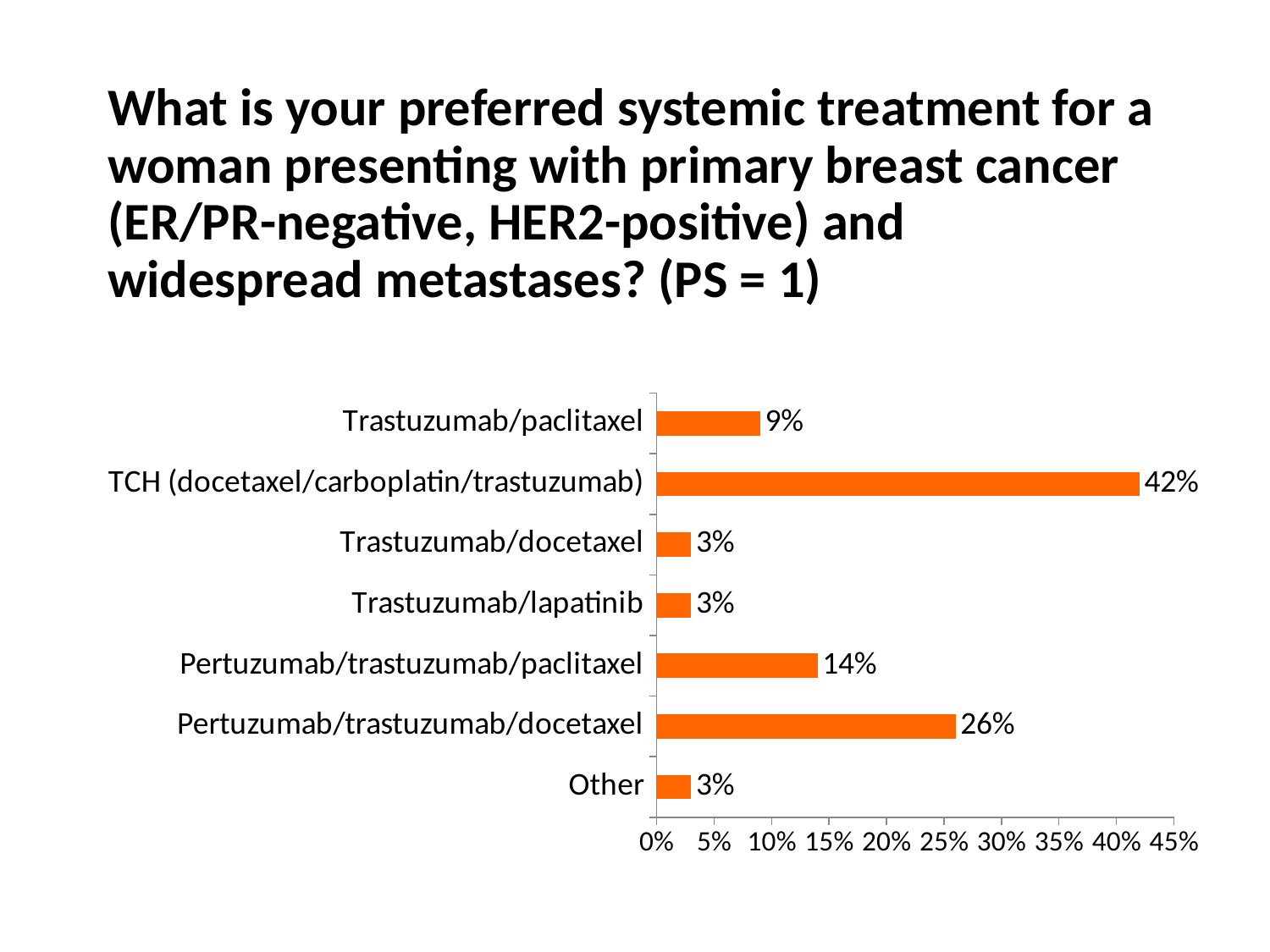
What is the difference between the values for TCH (docetaxel/carboplatin/trastuzumab) and Pertuzumab/trastuzumab/docetaxel? 16% What is the difference between the values for Pertuzumab/trastuzumab/paclitaxel and Trastuzumab/paclitaxel? 5% What percentage of respondents chose TCH (docetaxel/carboplatin/trastuzumab)? 42% What is the value for Pertuzumab/trastuzumab/docetaxel? 26% What kind of chart is shown on the slide? Bar chart Is the value for TCH (docetaxel/carboplatin/trastuzumab) greater or less than 40%? greater How many treatment options are shown in the chart? 7 What is the value for Pertuzumab/trastuzumab/paclitaxel? 14% Which is larger, the value for Pertuzumab/trastuzumab/docetaxel or the value for Pertuzumab/trastuzumab/paclitaxel? Pertuzumab/trastuzumab/docetaxel What is the value for Trastuzumab/paclitaxel? 9% Which treatment option has the highest percentage? TCH (docetaxel/carboplatin/trastuzumab) How many treatment options have a value of 3%? 3